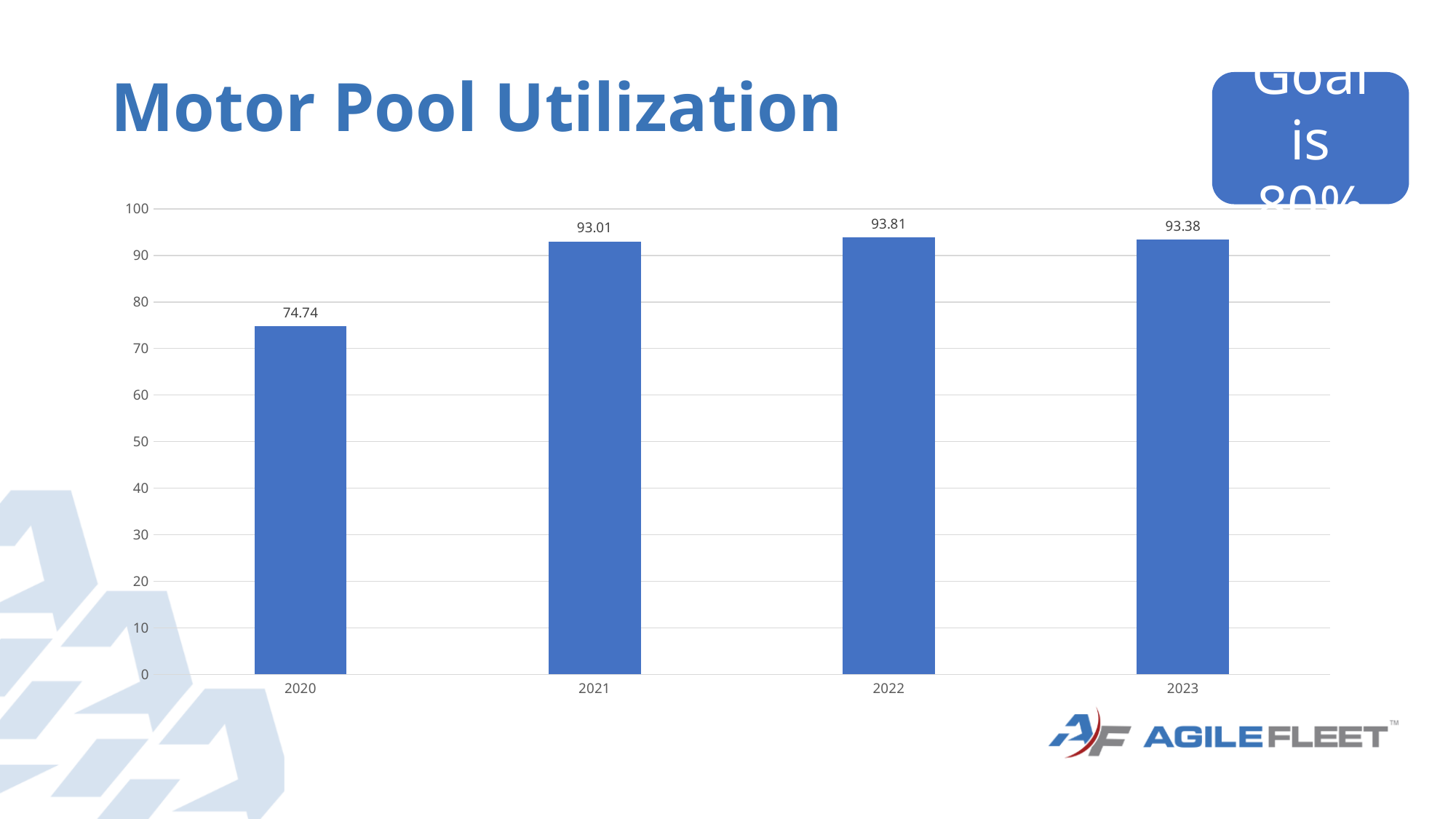
What is the motor pool utilization value for 2021? 93.01 Which year has the highest motor pool utilization? 2022 What is the difference between the 2022 and 2023 utilization values? 0.43 What is the motor pool utilization value for 2023? 93.38 What is the difference between the 2021 and 2020 utilization values? 18.27 Which year has the lowest motor pool utilization? 2020 Which year has a larger utilization value, 2020 or 2023? 2023 What is the motor pool utilization value for 2020? 74.74 What is the motor pool utilization value for 2022? 93.81 Is the value for 2020 greater or less than 80? less What kind of chart is shown on the slide? Bar chart How many years are shown on the chart? 4